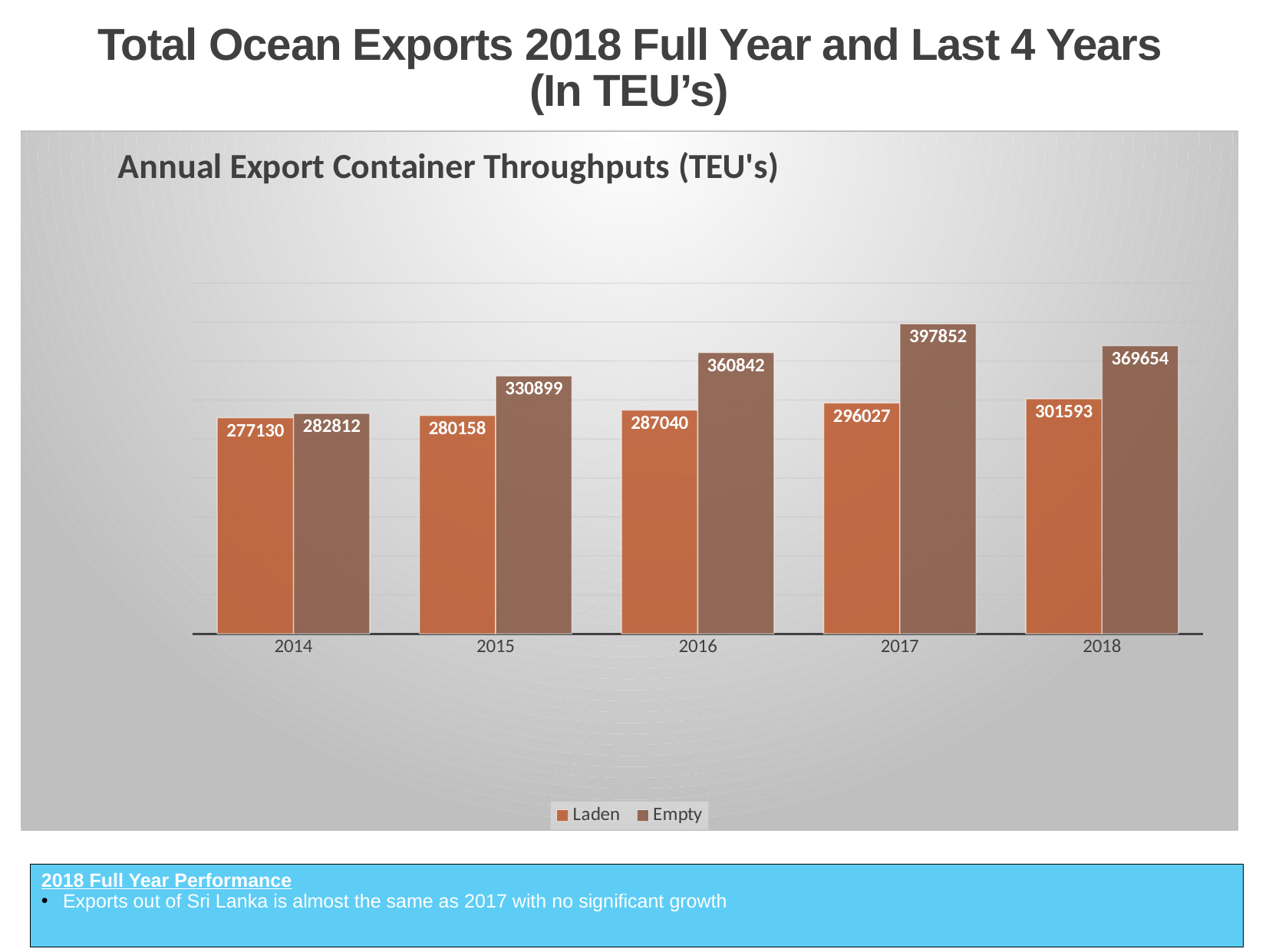
How many years are shown on the x axis? 5 Which is larger in 2015, the Laden value or the Empty value? Empty What is the Laden value for 2014? 277130 Which year has the lowest Laden value? 2014 How many series does the legend list? 2 What is the difference between the Empty and Laden values in 2017? 101825 By how much did the Laden value increase from 2017 to 2018? 5566 What is the Laden value for 2018? 301593 What kind of chart is shown on the slide? Bar chart What is the Empty value for 2016? 360842 Do the Laden values rise or fall from 2014 to 2018? Rise Which year has the highest Empty value? 2017